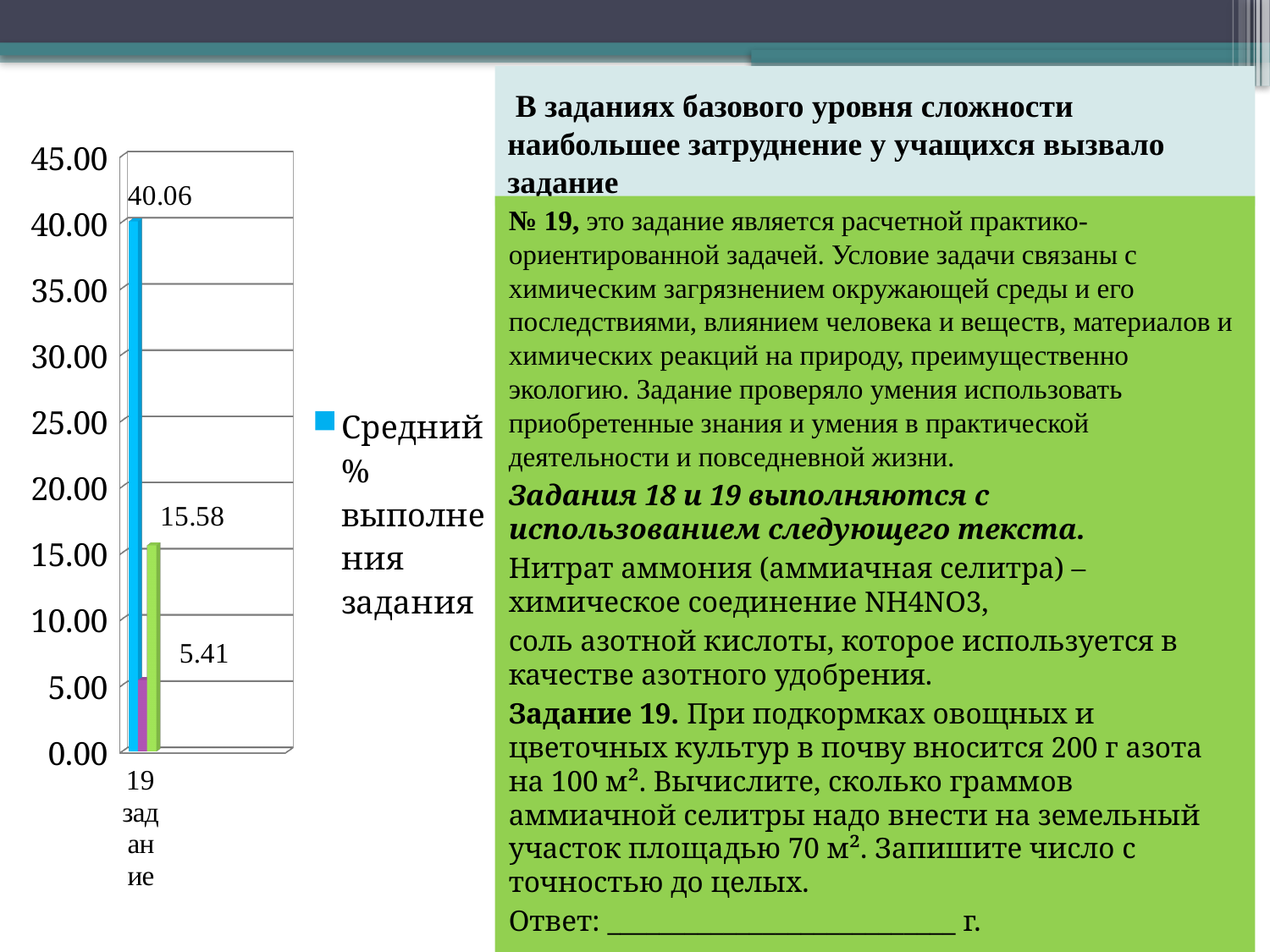
What is the value of the green bar for category 19 задание? 15.58 What is the legend entry shown next to the chart? Средний % выполнения задания What is the value of the purple bar for category 19 задание? 5.41 Which bar has the highest value in the chart? the blue bar (Средний % выполнения задания), 40.06 What is the value of the blue bar (Средний % выполнения задания) for category 19 задание? 40.06 What is the difference between the blue bar (40.06) and the green bar (15.58)? 24.48 Which bar has the lowest value in the chart? the purple bar, 5.41 Which is larger, the green bar or the purple bar? the green bar What type of chart is shown on the slide? bar chart Is the value of the blue bar greater or less than 35.00? greater What is the difference between the green bar (15.58) and the purple bar (5.41)? 10.17 How many categories are shown on the x axis of the chart? 1